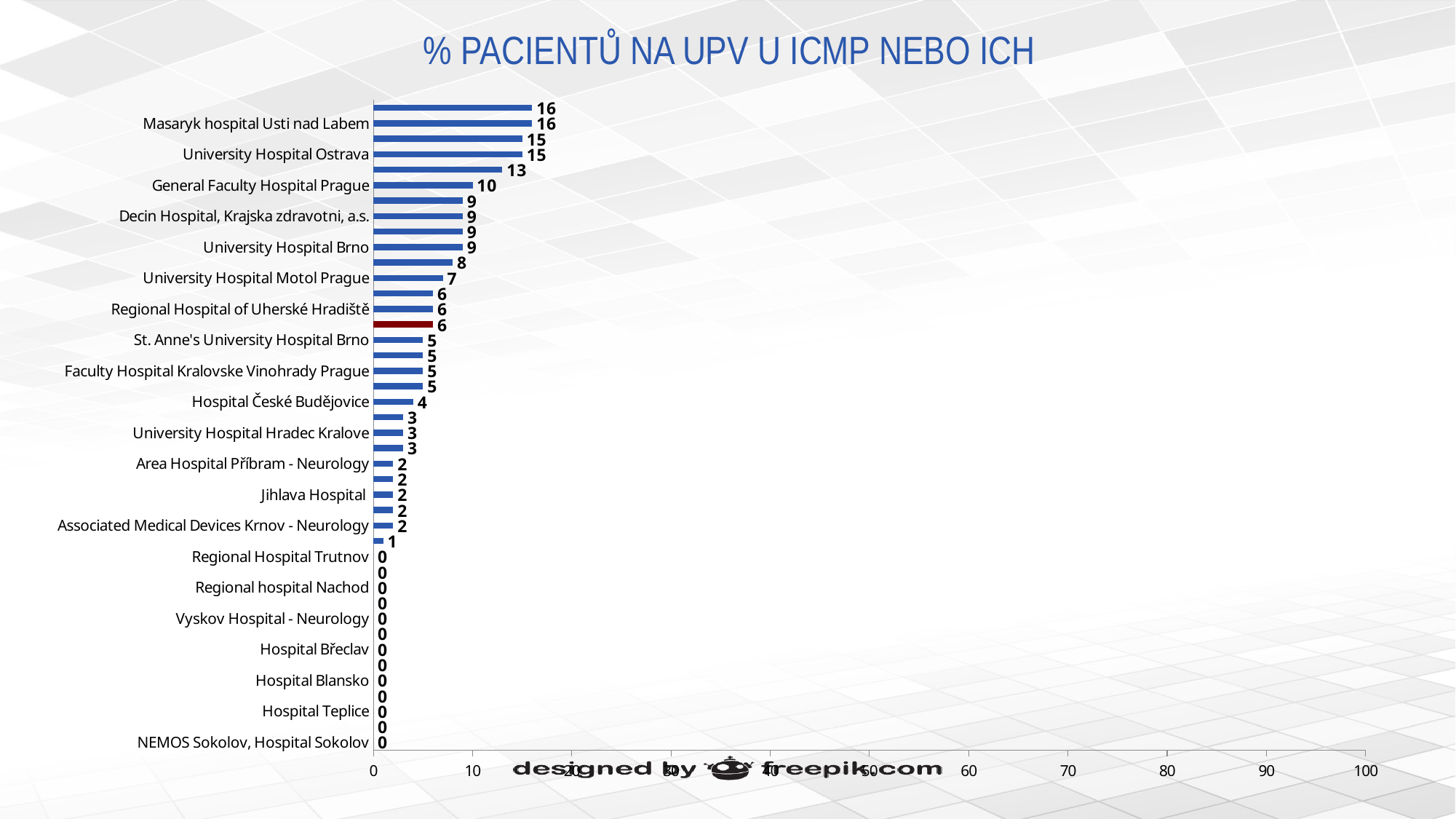
What is the title of the chart? % PACIENTŮ NA UPV U ICMP NEBO ICH What kind of chart is shown on the slide? bar chart What is the value for General Faculty Hospital Prague? 10 What is the difference between the values for Masaryk hospital Usti nad Labem and General Faculty Hospital Prague? 6 What is the value for University Hospital Motol Prague? 7 What is the value for Masaryk hospital Usti nad Labem? 16 Which has a larger value, University Hospital Brno or University Hospital Hradec Kralove? University Hospital Brno What is the value for University Hospital Ostrava? 15 What colour is the single highlighted bar that differs from the others? dark red What is the value for Hospital České Budějovice? 4 What is the value for Regional Hospital Trutnov? 0 Is the value for University Hospital Ostrava greater or less than 10? greater